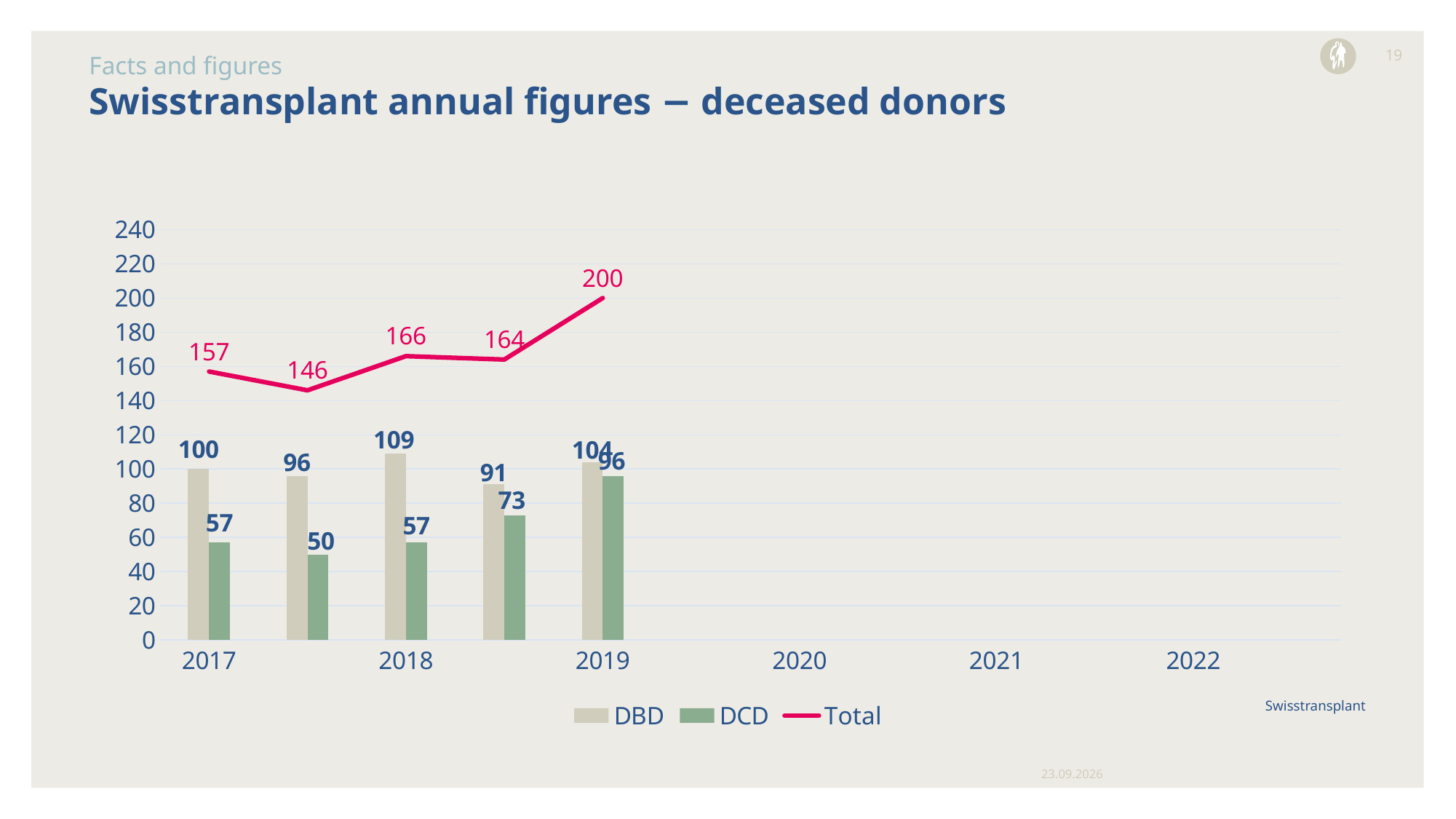
How many series does the legend list? 3 Which labelled year has the highest DBD value? 2018 What is the highest value shown on the Total line? 200 Which is larger for 2018, the DBD value or the DCD value? DBD By how much does the Total value for 2019 exceed the Total value for 2017? 43 What is the Total value for 2018? 166 What kind of chart is shown on the slide? Bar chart with a line What is the DBD value for 2017? 100 What is the DCD value for 2019? 96 What is the difference between the DBD and DCD values for 2019? 8 What is the lowest value shown on the Total line? 146 Does the Total line rise or fall between 2018 and 2019? rise